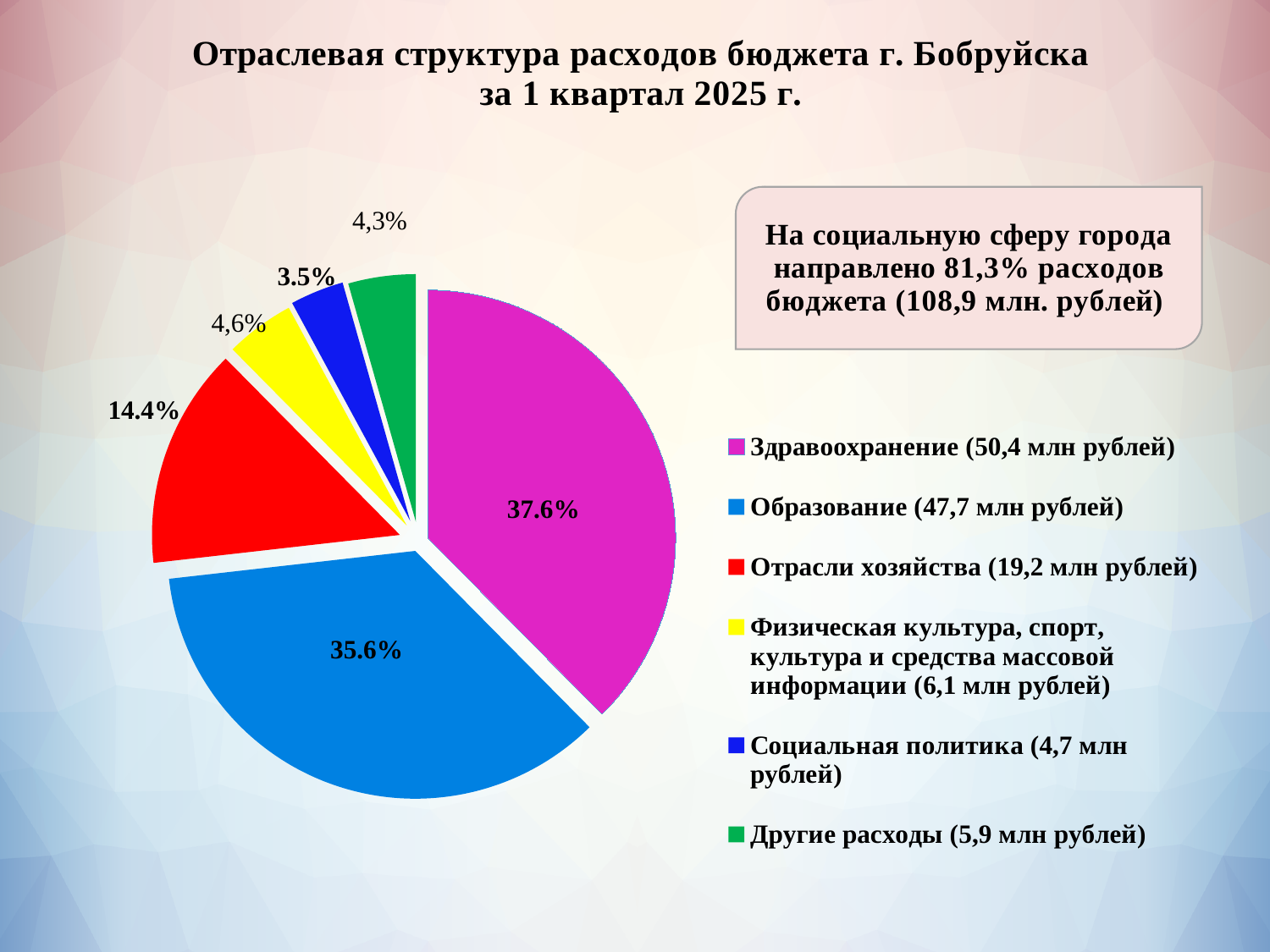
What amount in million rubles does the legend give for Образование? 47,7 млн рублей What share of the pie is labelled for Другие расходы? 4,3% What share of the pie is labelled for Отрасли хозяйства? 14.4% What colour is the slice for Отрасли хозяйства? red Which category has the smallest slice of the pie? Социальная политика What share of the pie is labelled for Образование? 35.6% How many categories does the legend list? 6 Which category has the largest slice of the pie? Здравоохранение Which slice is larger: Отрасли хозяйства or Другие расходы? Отрасли хозяйства What kind of chart is shown on the slide? pie chart